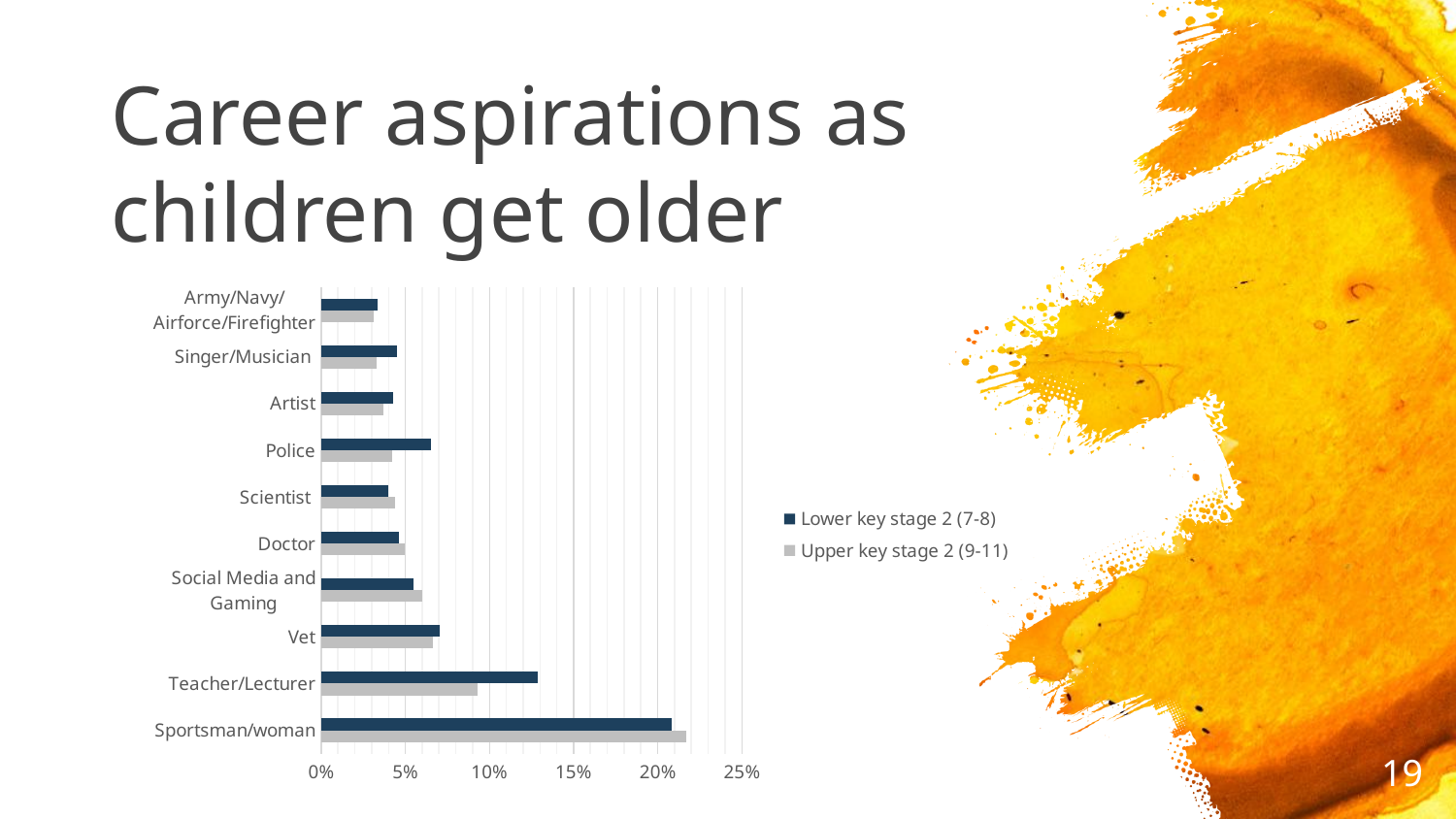
How many series does the chart's legend list? 2 Is the Lower key stage 2 (7-8) value for Sportsman/woman greater or less than 20%? greater What kind of chart is shown on the slide? Bar chart Which career category has the highest value for Lower key stage 2 (7-8)? Sportsman/woman What is the title of the slide containing the chart? Career aspirations as children get older Is the Upper key stage 2 (9-11) value for Teacher/Lecturer greater or less than 10%? less How many career categories are shown on the chart? 10 For Police, which series has the larger value: Lower key stage 2 (7-8) or Upper key stage 2 (9-11)? Lower key stage 2 (7-8) Is the Lower key stage 2 (7-8) value for Army/Navy/Airforce/Firefighter greater or less than 5%? less Which career category has the highest value for Upper key stage 2 (9-11)? Sportsman/woman For Teacher/Lecturer, which series has the larger value: Lower key stage 2 (7-8) or Upper key stage 2 (9-11)? Lower key stage 2 (7-8)